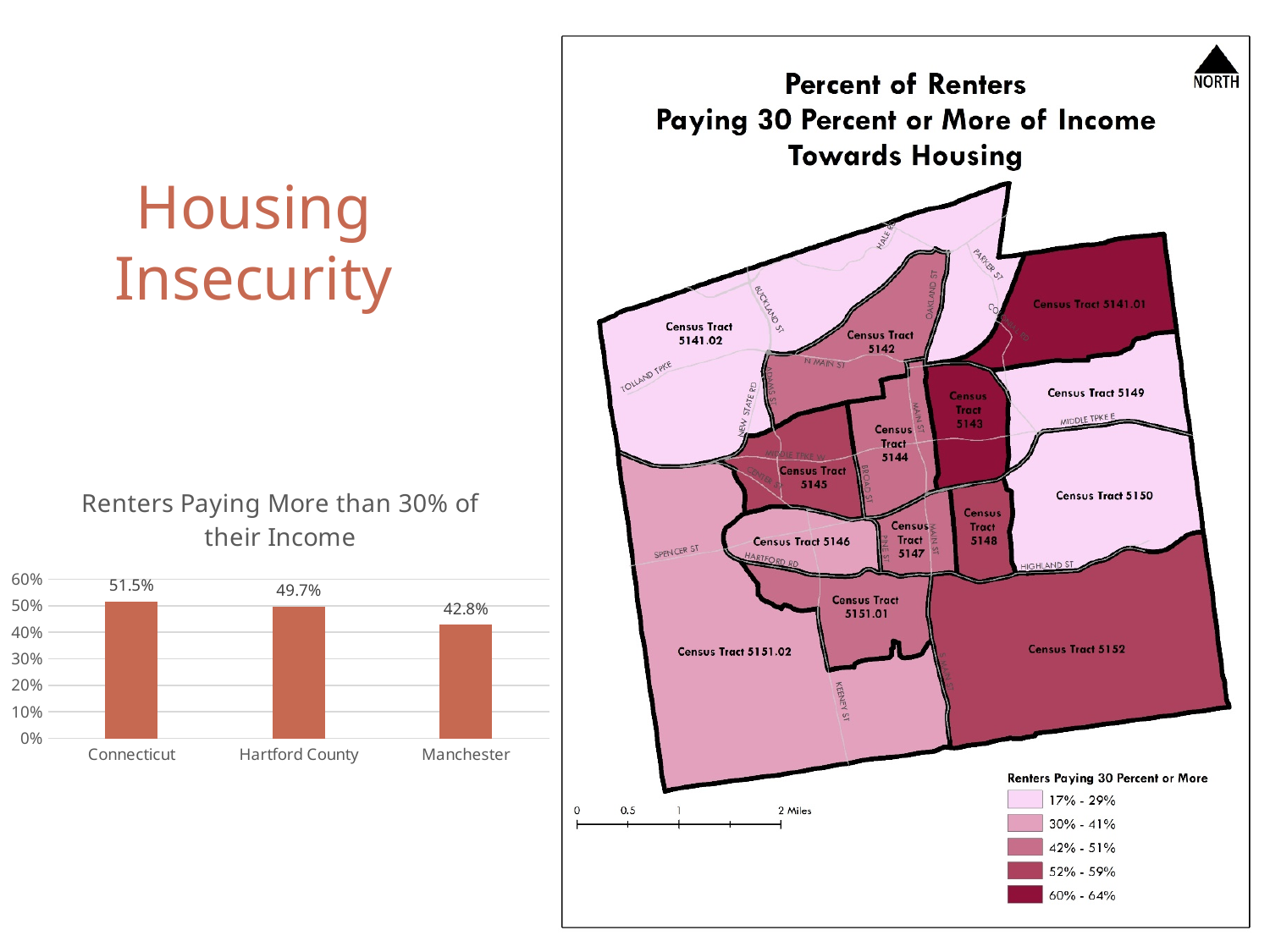
How many categories are shown in the bar chart 'Renters Paying More than 30% of their Income'? 3 In the bar chart 'Renters Paying More than 30% of their Income', do the values rise or fall from left to right? fall In the bar chart 'Renters Paying More than 30% of their Income', which category has the highest value? Connecticut In the bar chart 'Renters Paying More than 30% of their Income', what is the value for Manchester? 42.8% In the bar chart 'Renters Paying More than 30% of their Income', what is the value for Connecticut? 51.5% In the bar chart 'Renters Paying More than 30% of their Income', which is larger, the value for Hartford County or the value for Manchester? Hartford County In the bar chart 'Renters Paying More than 30% of their Income', what is the difference between the values for Connecticut and Manchester? 8.7% In the bar chart 'Renters Paying More than 30% of their Income', what is the difference between the values for Hartford County and Manchester? 6.9% In the bar chart 'Renters Paying More than 30% of their Income', which category has the lowest value? Manchester In the bar chart 'Renters Paying More than 30% of their Income', is the value for Manchester greater or less than 50%? less In the bar chart 'Renters Paying More than 30% of their Income', what is the value for Hartford County? 49.7% What kind of chart is 'Renters Paying More than 30% of their Income'? bar chart